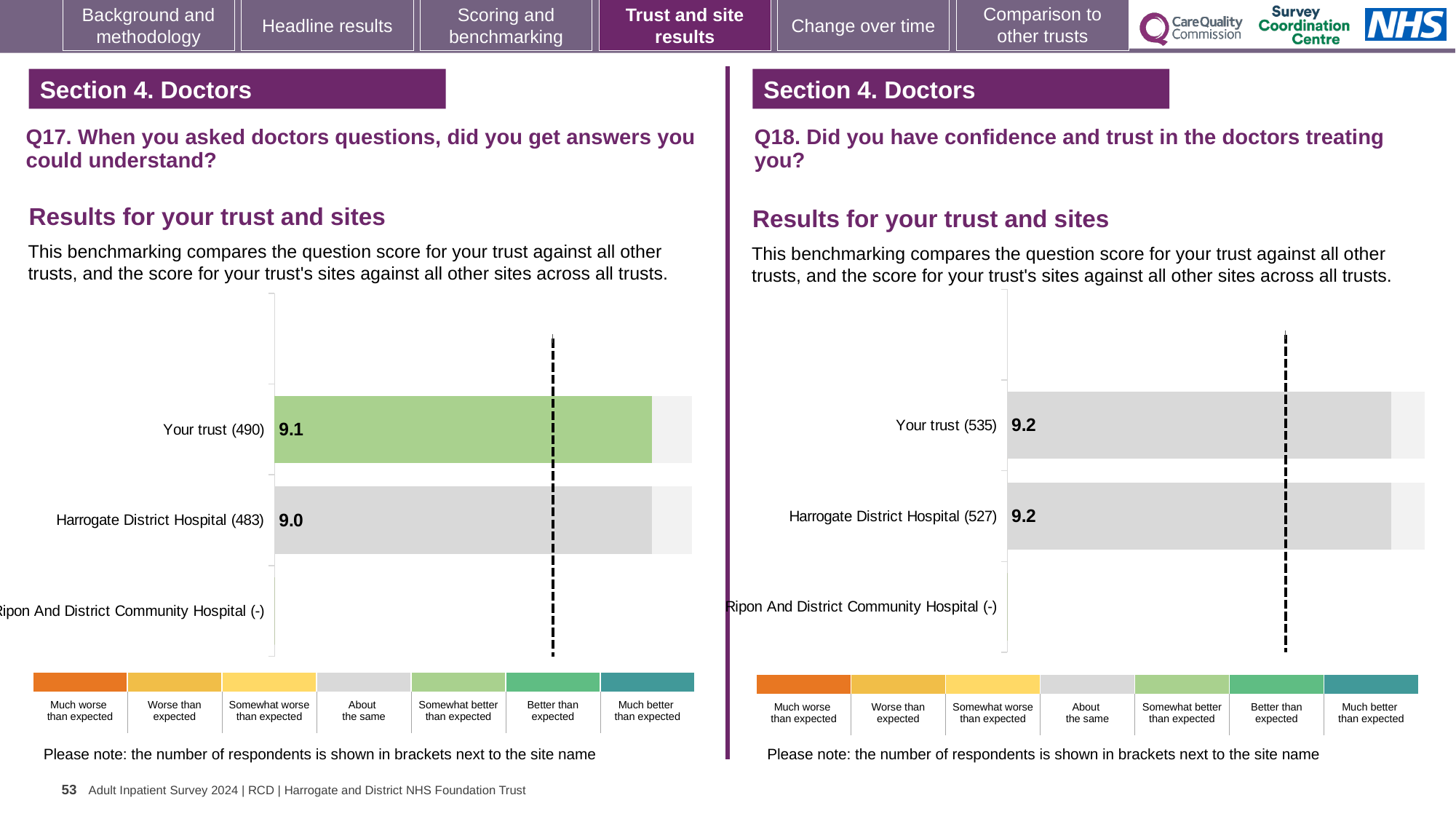
On the Q17 chart (left), what is the score for Your trust? 9.1 On the Q18 chart (right), what is the score for Harrogate District Hospital? 9.2 On the Q18 chart (right), how many respondents are shown in brackets for Harrogate District Hospital? 527 On the Q17 chart (left), what is the score for Harrogate District Hospital? 9.0 On the Q17 chart (left), which benchmark category does the colour of the Your trust bar correspond to in the legend? Somewhat better than expected On the Q17 chart (left), what is the difference between the score for Your trust and the score for Harrogate District Hospital? 0.1 On the Q17 chart (left), how many respondents are shown in brackets for Your trust? 490 On the Q17 chart (left), how many site or trust categories are listed on the vertical axis? 3 What kind of chart is used on the Q18 chart (right)? Bar chart On the Q17 chart (left), which has the higher score, Your trust or Harrogate District Hospital? Your trust On the Q18 chart (right), which benchmark category does the colour of the Your trust bar correspond to in the legend? About the same On the Q18 chart (right), what is the score for Your trust? 9.2